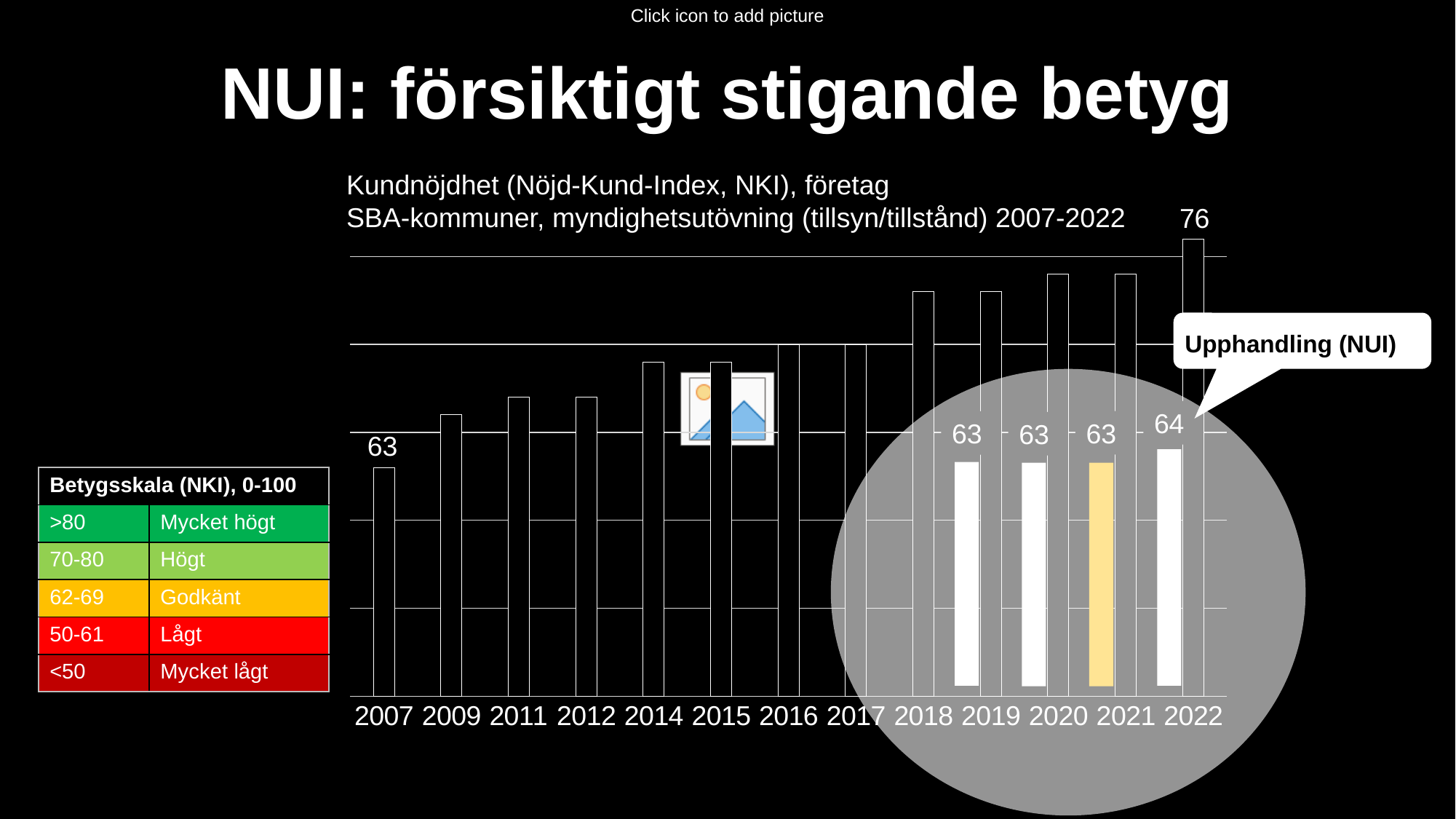
Do the NKI values generally rise or fall from 2007 to 2022? Rise Which is larger, the Upphandling (NUI) value for 2022 or for 2021? 2022 What is the difference between the Upphandling (NUI) values for 2022 and 2021? 1 What is the Upphandling (NUI) value shown for 2022? 64 Which year has the highest NKI bar? 2022 Which year has the lowest NKI bar? 2007 By how much does the NKI value for 2022 exceed the NKI value for 2007? 13 What is the Upphandling (NUI) value shown for 2019? 63 What is the NKI value shown for 2007? 63 What is the NKI value shown for 2022? 76 What kind of chart is shown on the slide? Bar chart How many years are shown on the x axis of the chart? 13